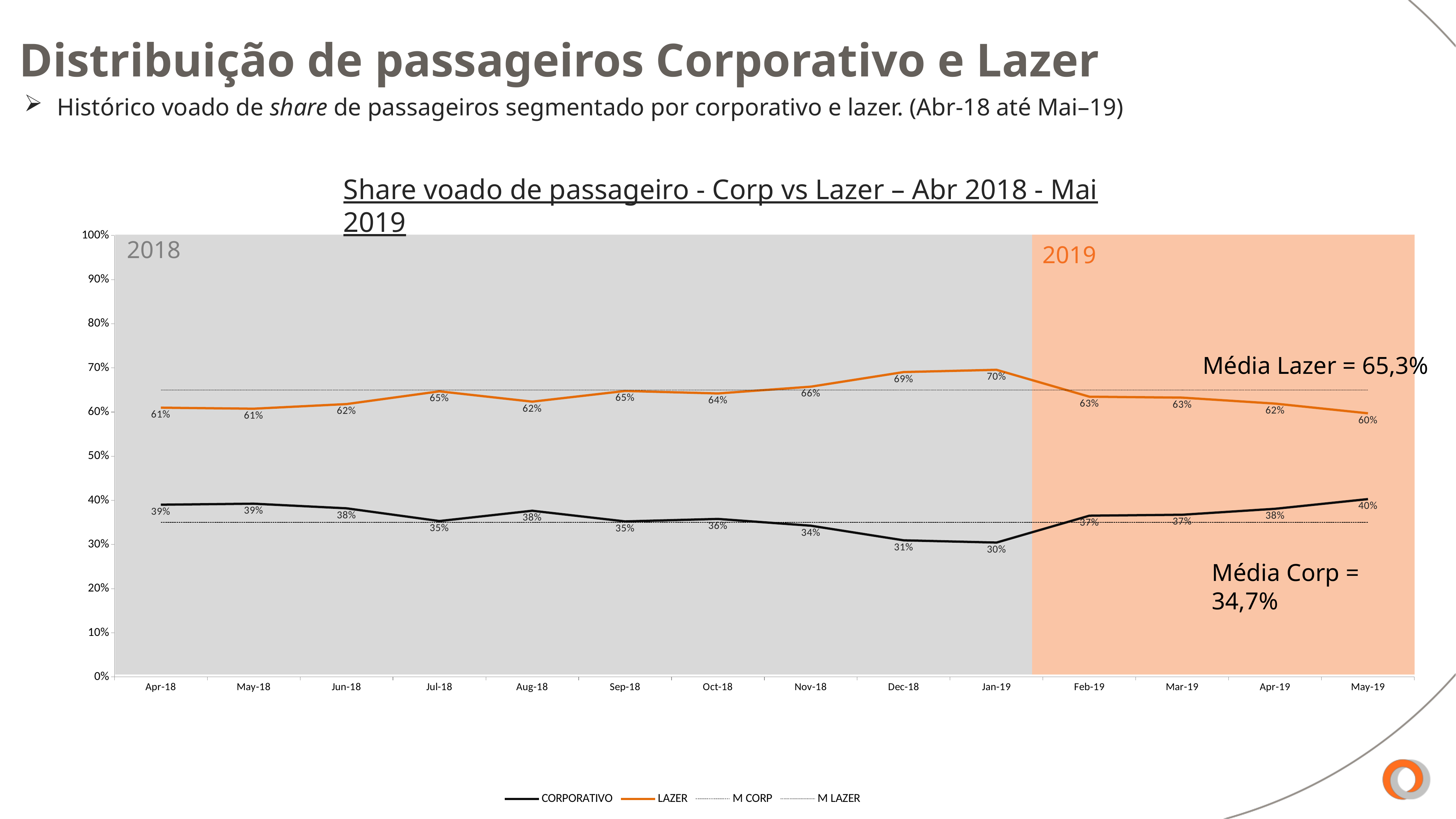
Which month has the larger CORPORATIVO share, Apr-18 or Nov-18? Apr-18 In which month does the LAZER series reach its highest value? Jan-19 What is the value given for Média Lazer on the chart? 65,3% What is the CORPORATIVO share in Dec-18? 31% How many months are plotted on the x axis? 14 In which month is the CORPORATIVO share lowest? Jan-19 In which month is the LAZER share lowest? May-19 What is the LAZER share in Jan-19? 70% How many entries does the legend list? 4 By how many percentage points does the LAZER share fall from Jan-19 to May-19? 10 percentage points In which month is the CORPORATIVO share highest? May-19 What kind of chart is shown on the slide? Line chart